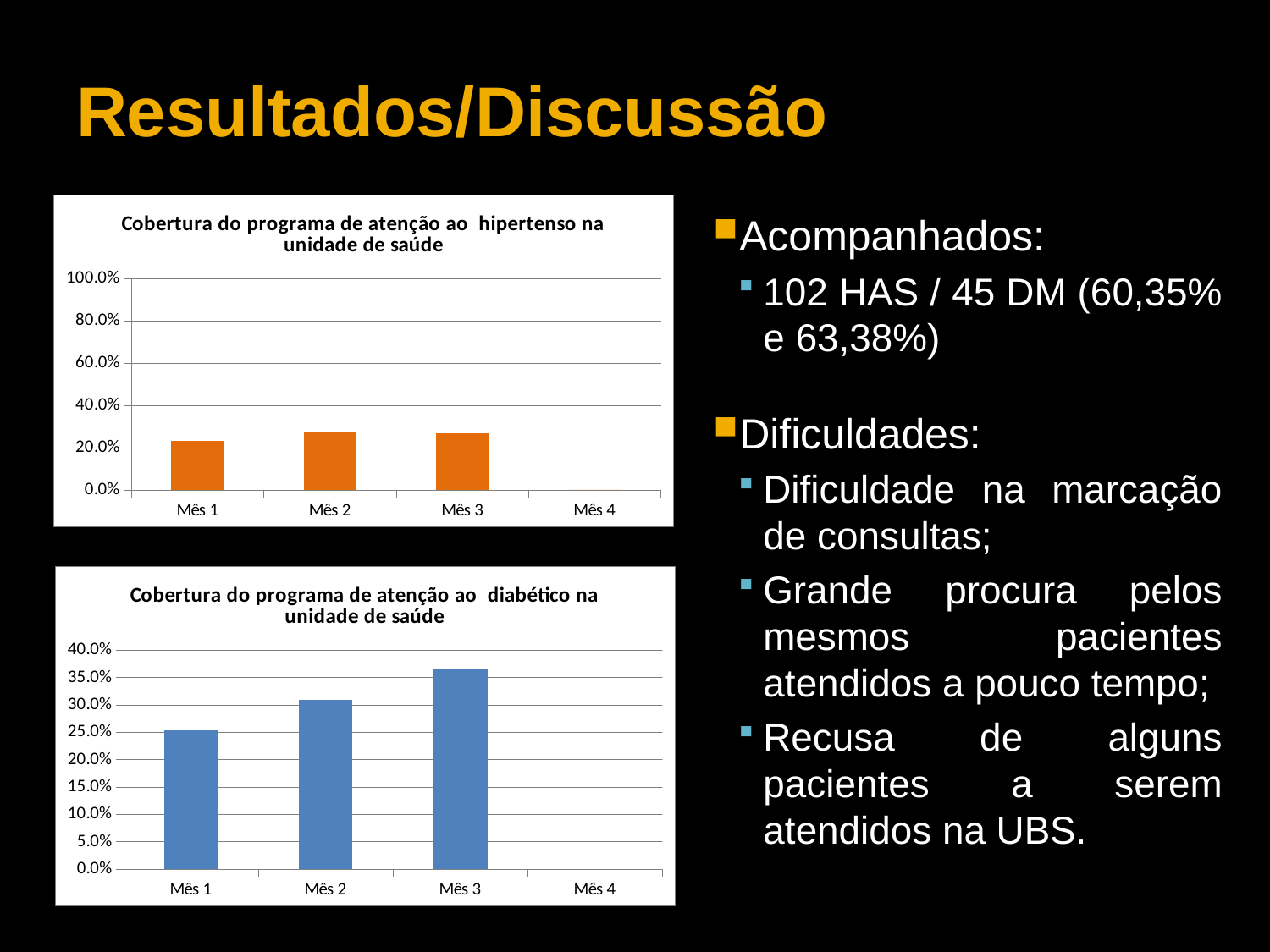
In the bottom chart (diabético), is the value for Mês 3 greater or less than 35.0%? greater In the bottom chart (diabético), which month has the lowest coverage? Mês 4 In the bottom chart (diabético), which is larger, the value for Mês 1 or the value for Mês 3? Mês 3 In the top chart (hipertenso), is the value for Mês 2 greater or less than 20.0%? greater How many categories are shown on the x axis of the bottom chart, 'Cobertura do programa de atenção ao diabético na unidade de saúde'? 4 What kind of chart is the top chart, 'Cobertura do programa de atenção ao hipertenso na unidade de saúde'? Bar chart In the top chart (hipertenso), is the value for Mês 1 greater or less than 40.0%? less In the top chart (hipertenso), which month has the lowest coverage? Mês 4 In the bottom chart (diabético), which month has the highest coverage? Mês 3 What is the highest value shown on the y axis of the top chart (hipertenso)? 100.0% In the bottom chart (diabético), do the values rise or fall from Mês 1 to Mês 3? Rise